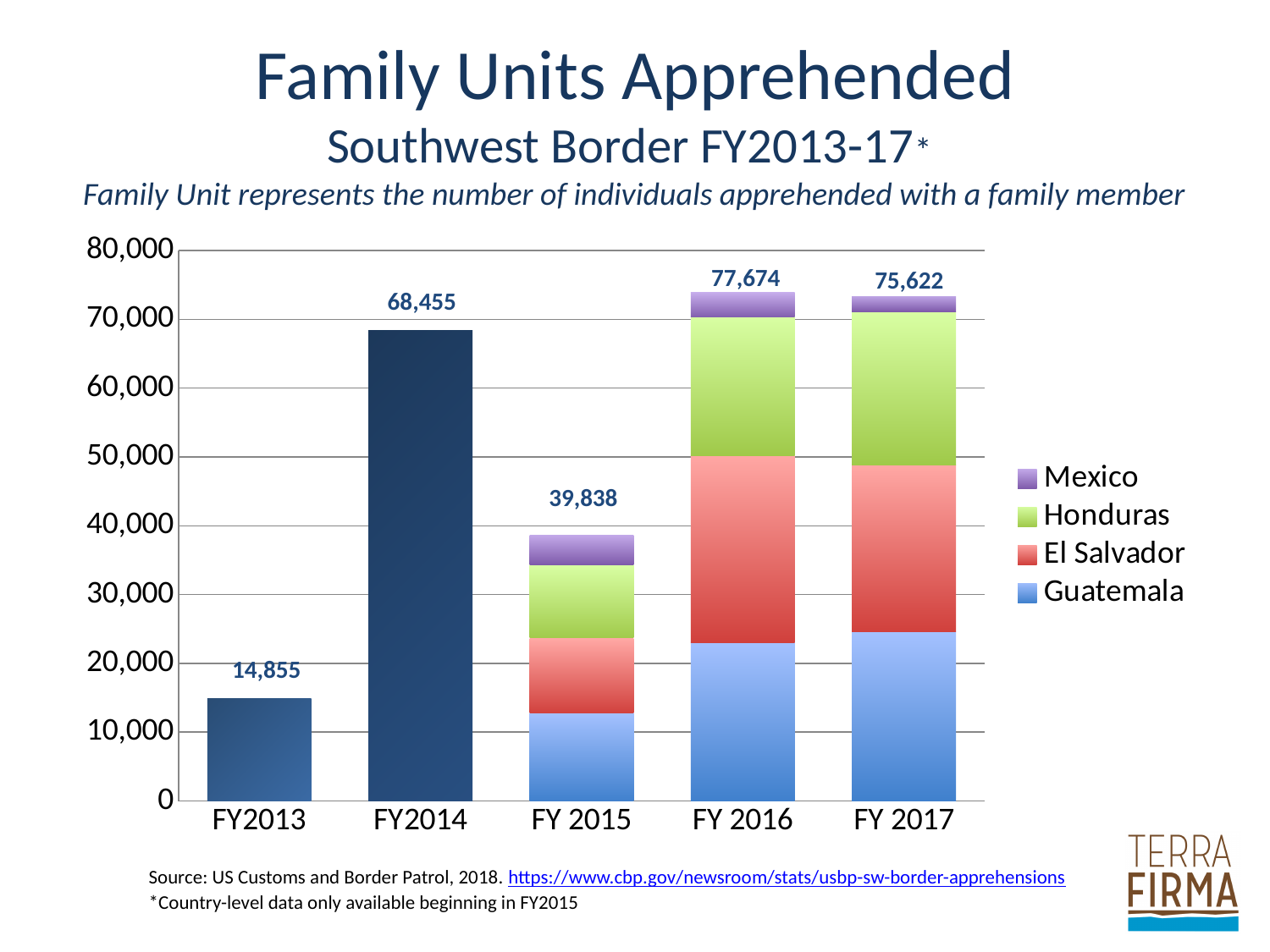
What is the difference between the labeled totals for FY 2016 and FY 2017? 2,052 By how much does the labeled total for FY2014 exceed that for FY2013? 53,600 Which fiscal year has the lowest labeled total of family units apprehended? FY2013 Which has the larger labeled total, FY2014 or FY 2015? FY2014 Is the Guatemala segment for FY 2017 greater or less than 20,000? greater How many countries are listed in the legend? 4 What kind of chart is shown on the slide? Stacked bar chart What is the labeled value for FY2013? 14,855 What is the labeled value for FY2014? 68,455 Which fiscal year has the highest labeled total of family units apprehended? FY 2016 How many fiscal years are shown on the x axis? 5 Is the El Salvador segment for FY 2016 greater or less than 20,000? greater